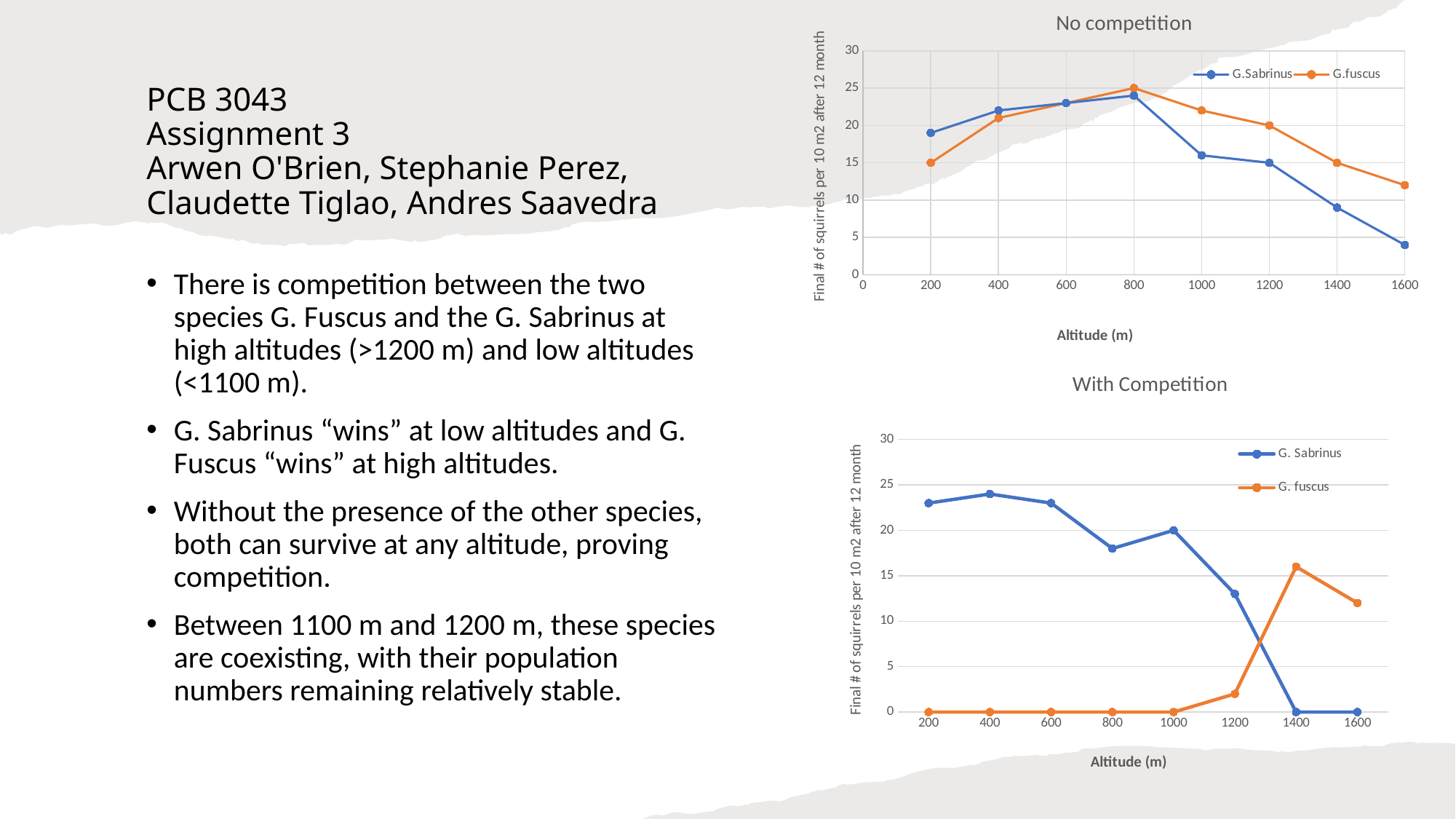
In the "With Competition" chart, is the value for G. fuscus at 1400 m greater or less than 15? greater In the "No competition" chart, does G.Sabrinus rise or fall from 800 m to 1600 m? fall In the "With Competition" chart, what is the value for G. Sabrinus at 1000 m? 20 In the "No competition" chart, is the value for G.Sabrinus at 1600 m greater or less than 5? less In the "No competition" chart, what is the value for G.fuscus at 200 m? 15 In the "With Competition" chart, at which altitude is G. fuscus highest? 1400 In the "No competition" chart, what is the value for G.fuscus at 800 m? 25 In the "No competition" chart, at which altitude is G.fuscus highest? 800 What kind of chart is the "No competition" chart? line chart How many series does the legend of the "With Competition" chart list? 2 In the "With Competition" chart, what is the value for G. fuscus at 200 m? 0 In the "No competition" chart, which series has the larger value at 1600 m? G.fuscus